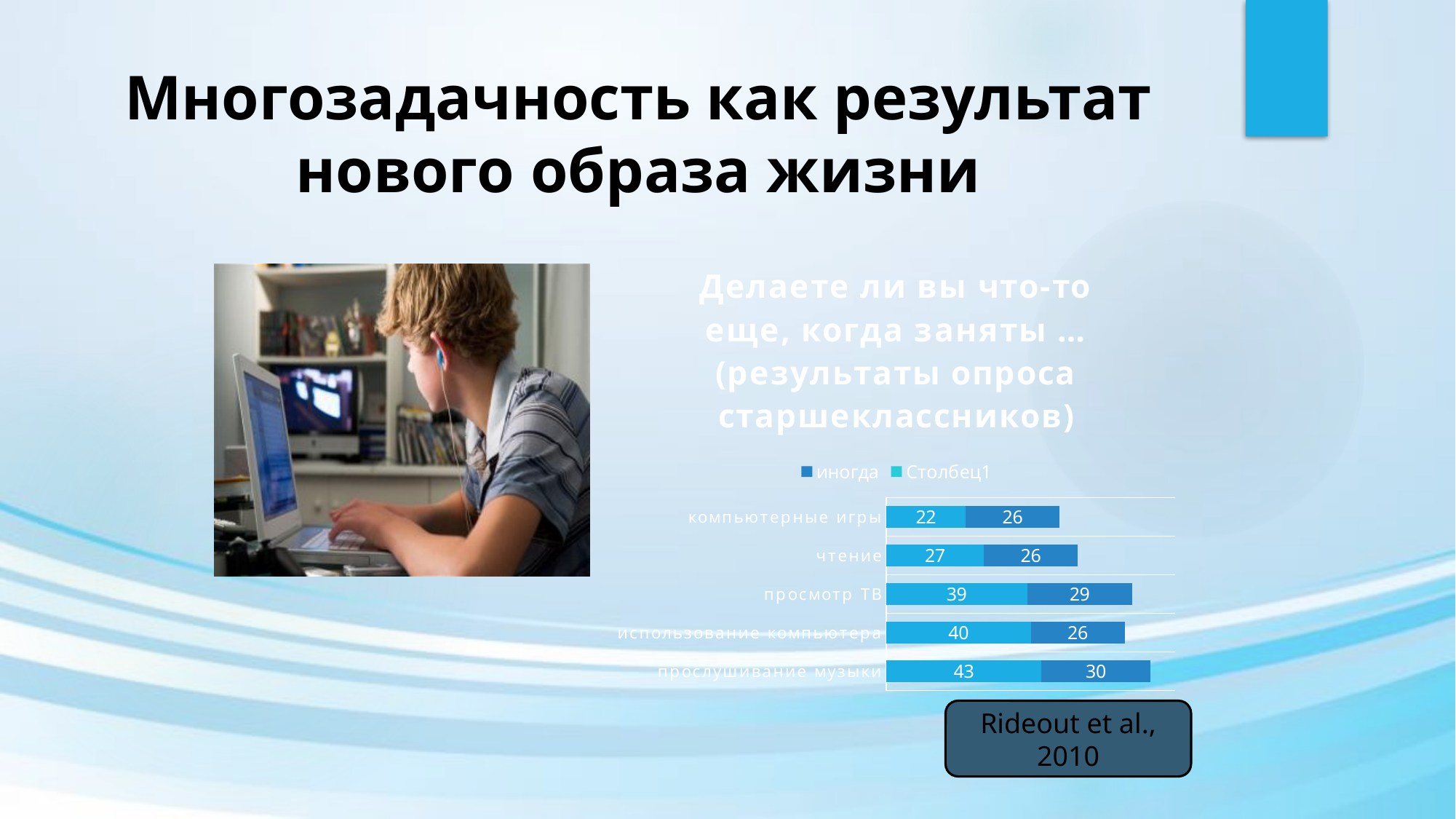
What is the total of the stacked bar for прослушивание музыки? 73 Which category has the shortest stacked bar overall? компьютерные игры How many series does the chart legend list? 2 What is the total of the stacked bar for просмотр ТВ? 68 What are the two entries listed in the chart legend? иногда and Столбец1 What is the total of the stacked bar for компьютерные игры? 48 Which category has the longest stacked bar overall? прослушивание музыки How many categories does the chart show? 5 What is the value of the dark blue segment for просмотр ТВ? 29 What kind of chart is shown on the slide? stacked bar chart What is the value of the light blue segment for использование компьютера? 40 What is the difference between the light blue segments for прослушивание музыки and чтение? 16